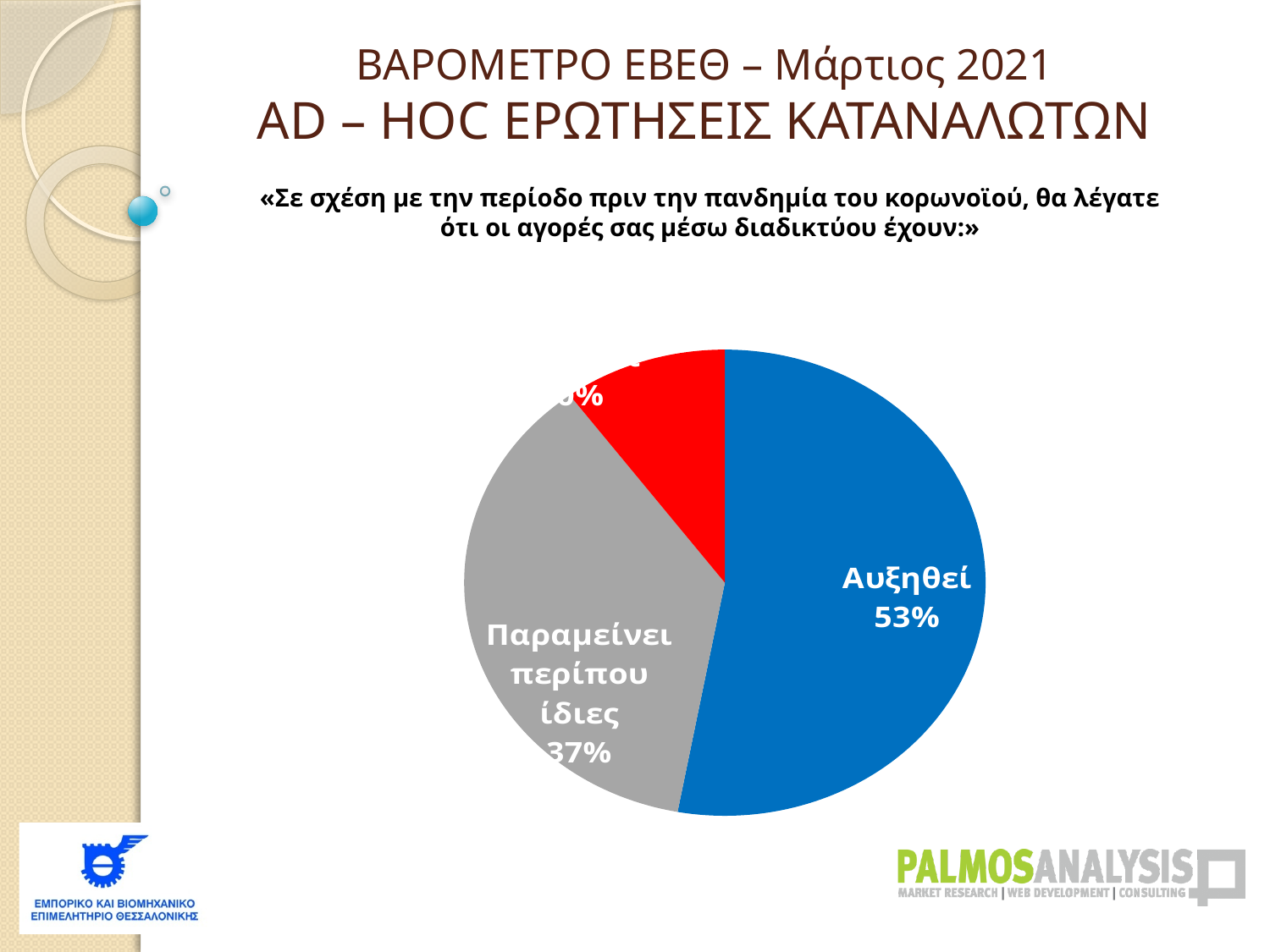
Which slice of the pie is the smallest? The red slice Which response has the largest share of the pie? Αυξηθεί What colour is the Αυξηθεί slice? Blue What kind of chart is shown on the slide? Pie chart What share of the pie does the Αυξηθεί slice represent? 53% Is the share for Αυξηθεί greater or less than 50%? greater By how many percentage points does Αυξηθεί exceed Παραμείνει περίπου ίδιες? 16 percentage points What percentage of respondents said their online purchases have remained about the same (Παραμείνει περίπου ίδιες)? 37% What percentage of respondents said their online purchases have increased (Αυξηθεί)? 53% How many slices does the pie chart have? 3 Which is larger: the share for Αυξηθεί or the share for Παραμείνει περίπου ίδιες? Αυξηθεί What colour is the Παραμείνει περίπου ίδιες slice? Grey